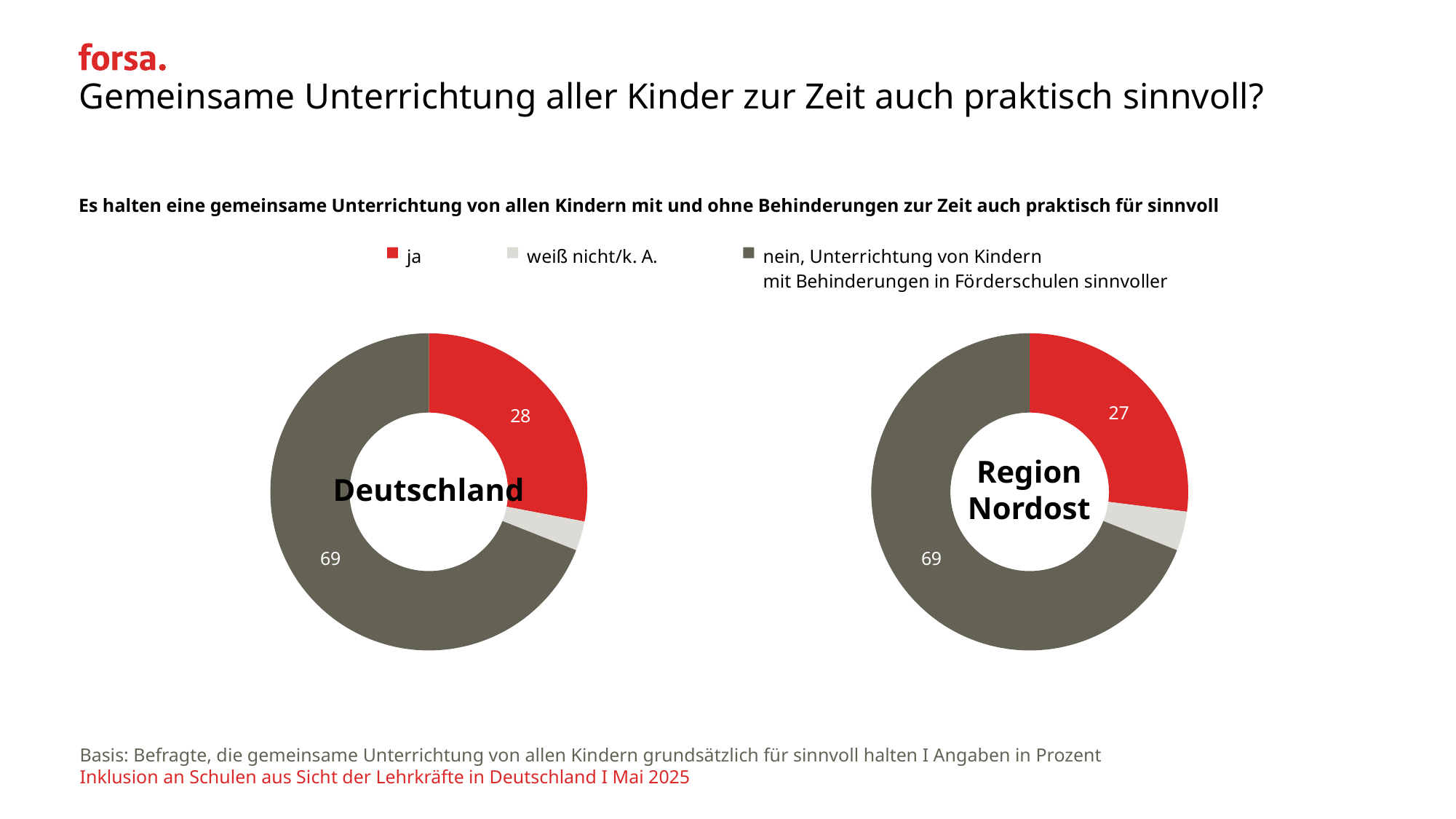
In the Deutschland chart, which category has the largest share? nein, Unterrichtung von Kindern mit Behinderungen in Förderschulen sinnvoller In the Region Nordost chart, what is the value for "nein, Unterrichtung von Kindern mit Behinderungen in Förderschulen sinnvoller"? 69 How many categories does the legend list? 3 In the Region Nordost chart, what is the difference between the "nein" value and the "ja" value? 42 In the Deutschland chart, what is the value for "ja"? 28 In the Region Nordost chart, what is the value for "ja"? 27 In the Region Nordost chart, which category has the smallest share? weiß nicht/k. A. In the Deutschland chart, what is the difference between the "nein" value and the "ja" value? 41 In the Deutschland chart, what is the value for "nein, Unterrichtung von Kindern mit Behinderungen in Förderschulen sinnvoller"? 69 What kind of chart is used for Deutschland and Region Nordost? Donut (pie) chart Is the "ja" value larger in the Deutschland chart or in the Region Nordost chart? Deutschland Which colour represents "ja" in the charts? Red